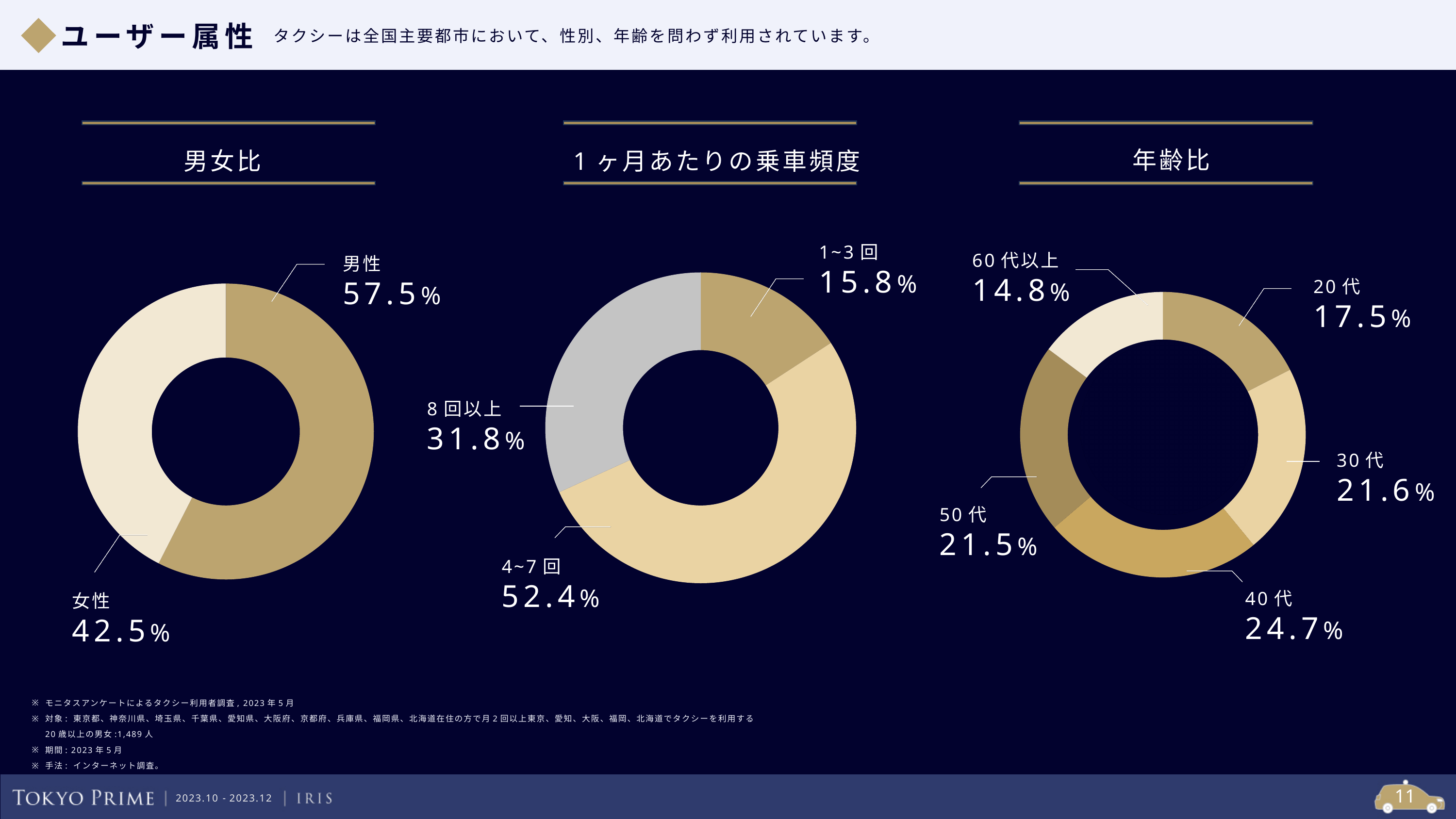
In the 年齢比 chart, how many age categories are shown? 5 In the 年齢比 chart, which category has the highest value? 40代 In the 年齢比 chart, what is the value for 40代? 24.7% In the 1ヶ月あたりの乗車頻度 chart, what is the value for 4~7回? 52.4% What kind of chart is the 年齢比 chart? Donut chart In the 男女比 chart, what is the value for 男性? 57.5% In the 1ヶ月あたりの乗車頻度 chart, what is the difference between 8回以上 and 1~3回? 16.0% In the 男女比 chart, what is the difference between 男性 and 女性? 15.0% In the 年齢比 chart, which category has the lowest value? 60代以上 In the 1ヶ月あたりの乗車頻度 chart, how many categories are shown? 3 In the 男女比 chart, what is the value for 女性? 42.5% In the 1ヶ月あたりの乗車頻度 chart, which category has the lowest value? 1~3回